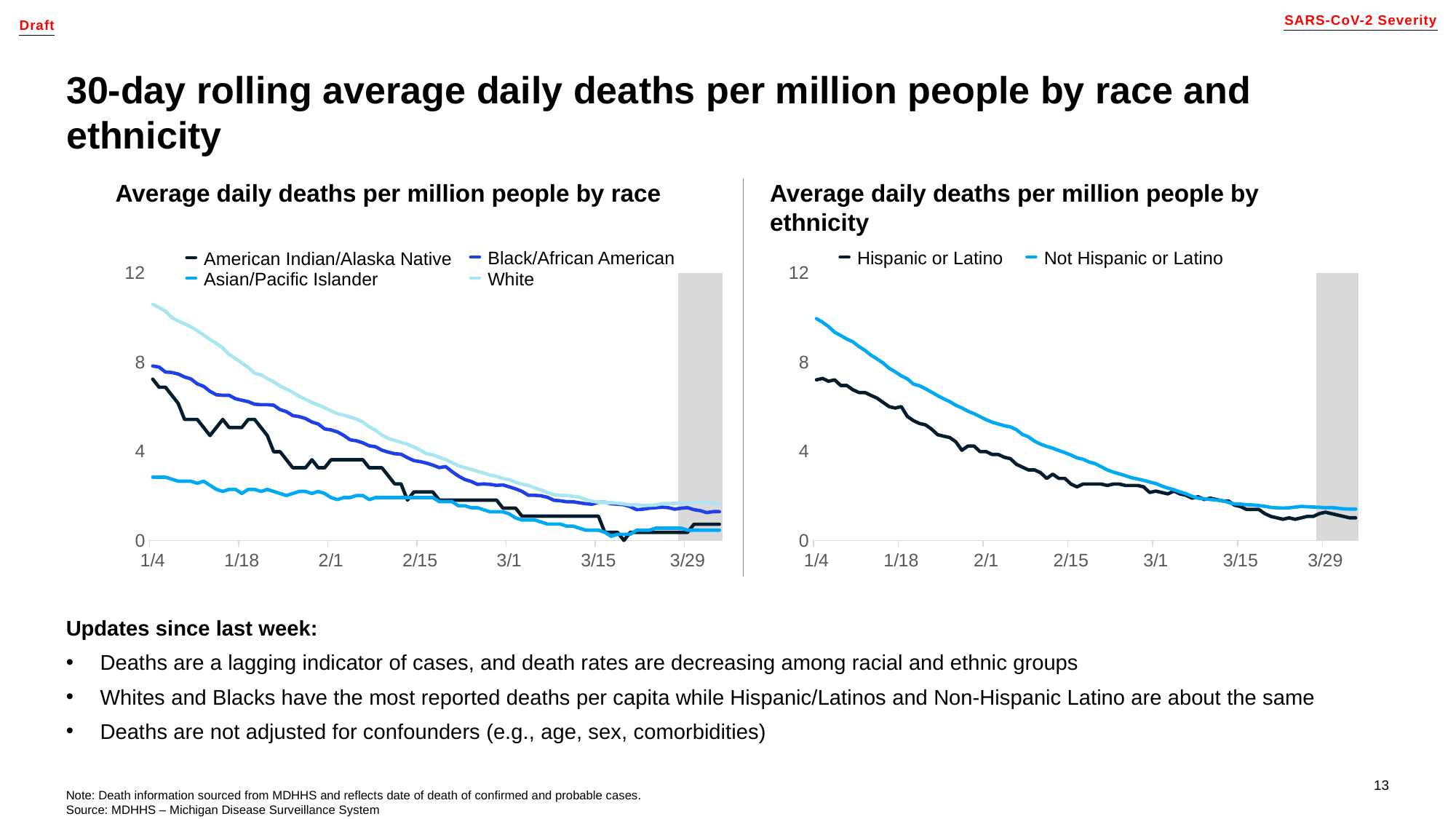
In the right chart, 'Average daily deaths per million people by ethnicity', is the value for Not Hispanic or Latino at 1/4 greater or less than 8? greater In the left chart, 'Average daily deaths per million people by race', does the White series rise or fall from 1/4 to 3/29? fall In the left chart, 'Average daily deaths per million people by race', which series has the highest value at 1/4? White In the right chart, 'Average daily deaths per million people by ethnicity', which series has the higher value at 1/4? Not Hispanic or Latino How many series does the legend of the left chart, 'Average daily deaths per million people by race', list? 4 In the left chart, 'Average daily deaths per million people by race', is the value for White at 1/4 greater or less than 8? greater In the right chart, 'Average daily deaths per million people by ethnicity', does the Hispanic or Latino series rise or fall from 1/4 to 3/29? fall How many series does the legend of the right chart, 'Average daily deaths per million people by ethnicity', list? 2 In the left chart, 'Average daily deaths per million people by race', which is larger at 1/4: White or Asian/Pacific Islander? White What kind of chart is the left chart, 'Average daily deaths per million people by race'? line chart In the left chart, 'Average daily deaths per million people by race', is the value for Asian/Pacific Islander at 1/4 greater or less than 4? less What is the title of the right chart? Average daily deaths per million people by ethnicity